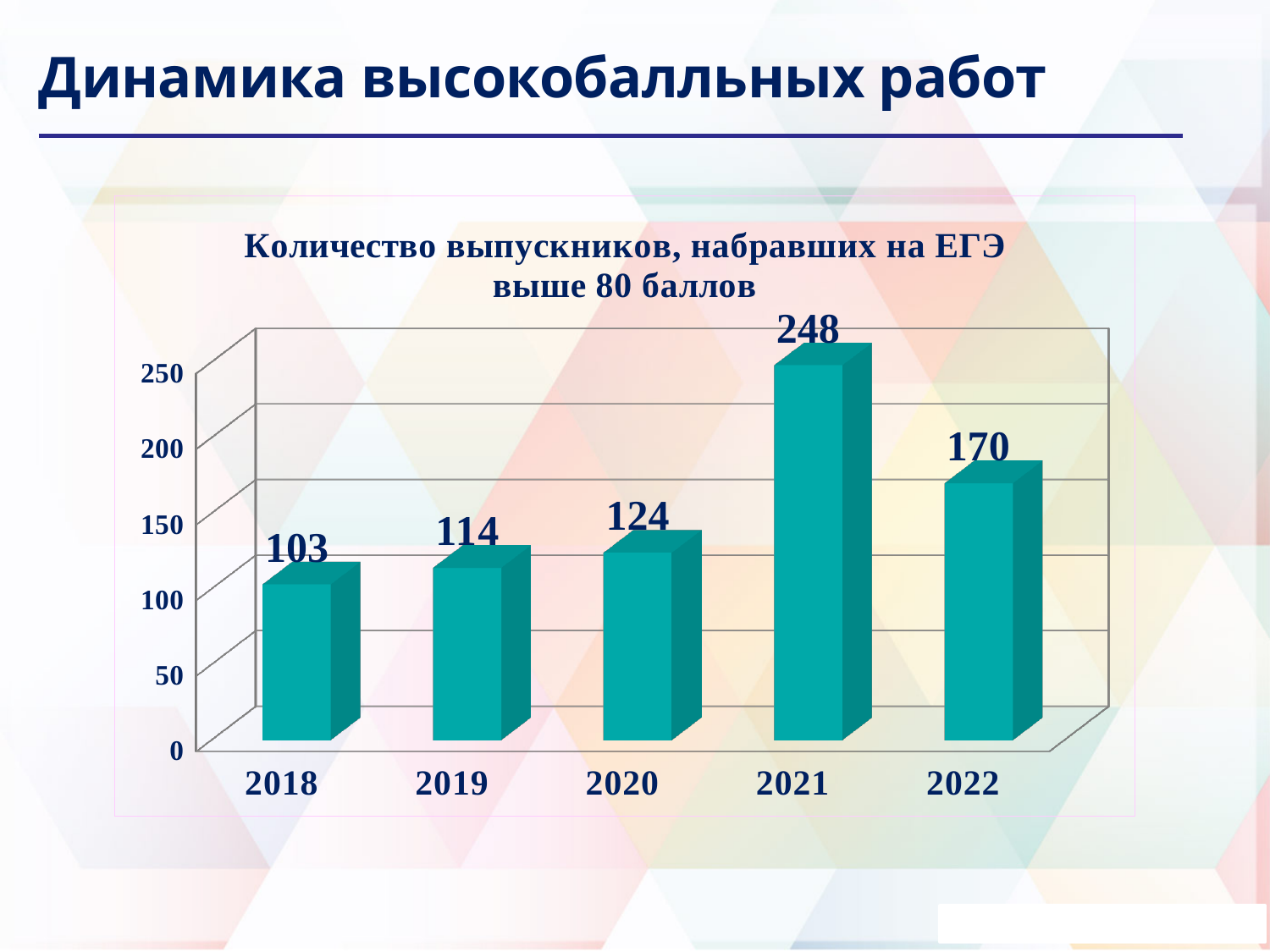
Is the value for 2020 greater or less than 150? less What kind of chart is shown on the slide? bar chart What is the value for 2022? 170 Which is larger, the value for 2019 or the value for 2022? 2022 What is the difference between the values for 2020 and 2019? 10 How many years are shown on the x axis? 5 Which year has the highest value? 2021 What is the difference between the values for 2021 and 2022? 78 What is the value for 2021? 248 What is the title of the chart? Количество выпускников, набравших на ЕГЭ выше 80 баллов What is the value for 2018? 103 Which year has the lowest value? 2018